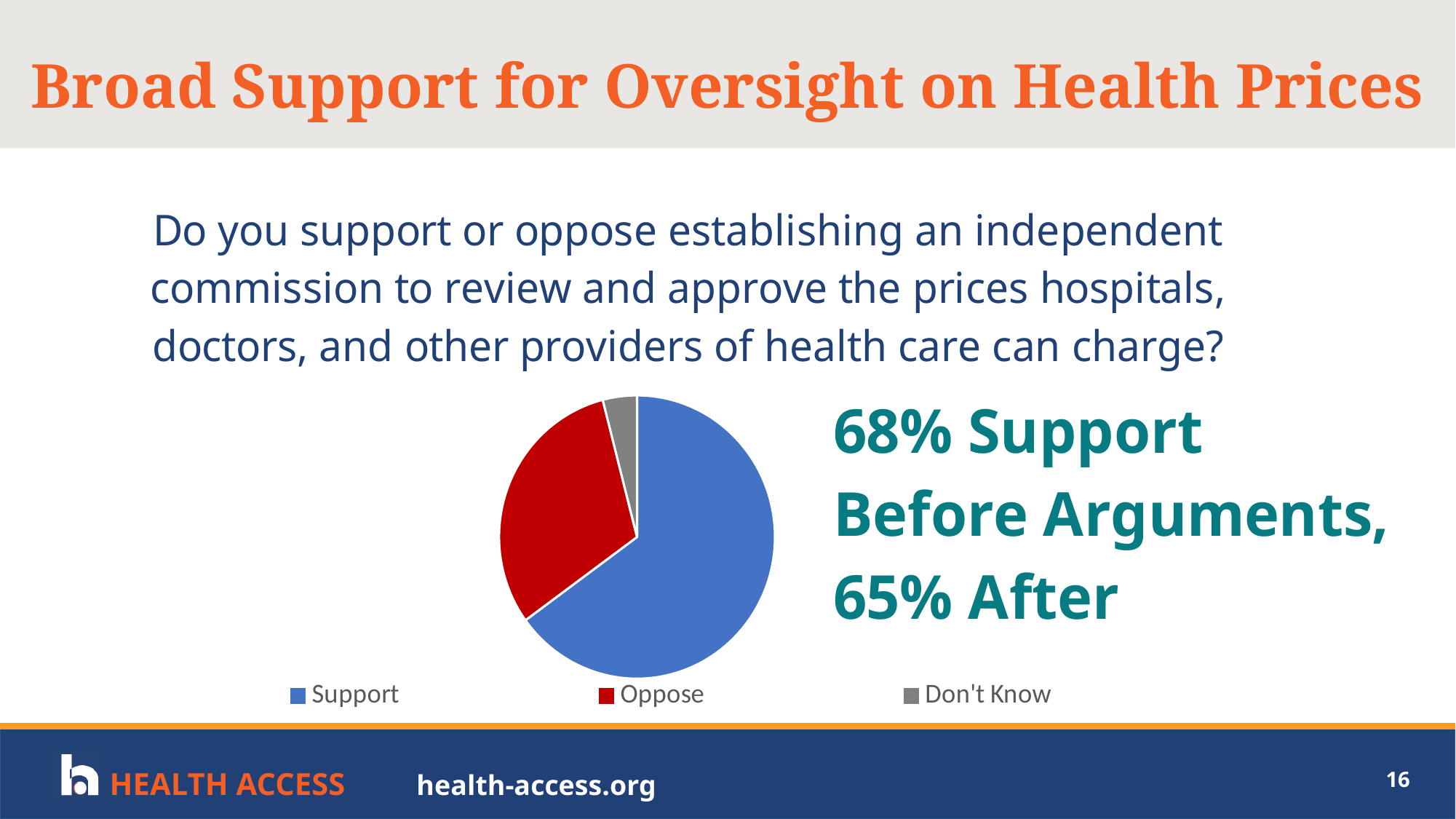
Which slice is larger in the pie chart, Oppose or Don't Know? Oppose Which category has the smallest slice in the pie chart? Don't Know What colour is the Oppose slice in the pie chart? red Which slice is larger in the pie chart, Support or Oppose? Support How many slices does the pie chart have? 3 How many entries does the legend of the pie chart list? 3 What colour is the Support slice in the pie chart? blue Which category has the largest slice in the pie chart? Support What kind of chart is shown on the slide? pie chart